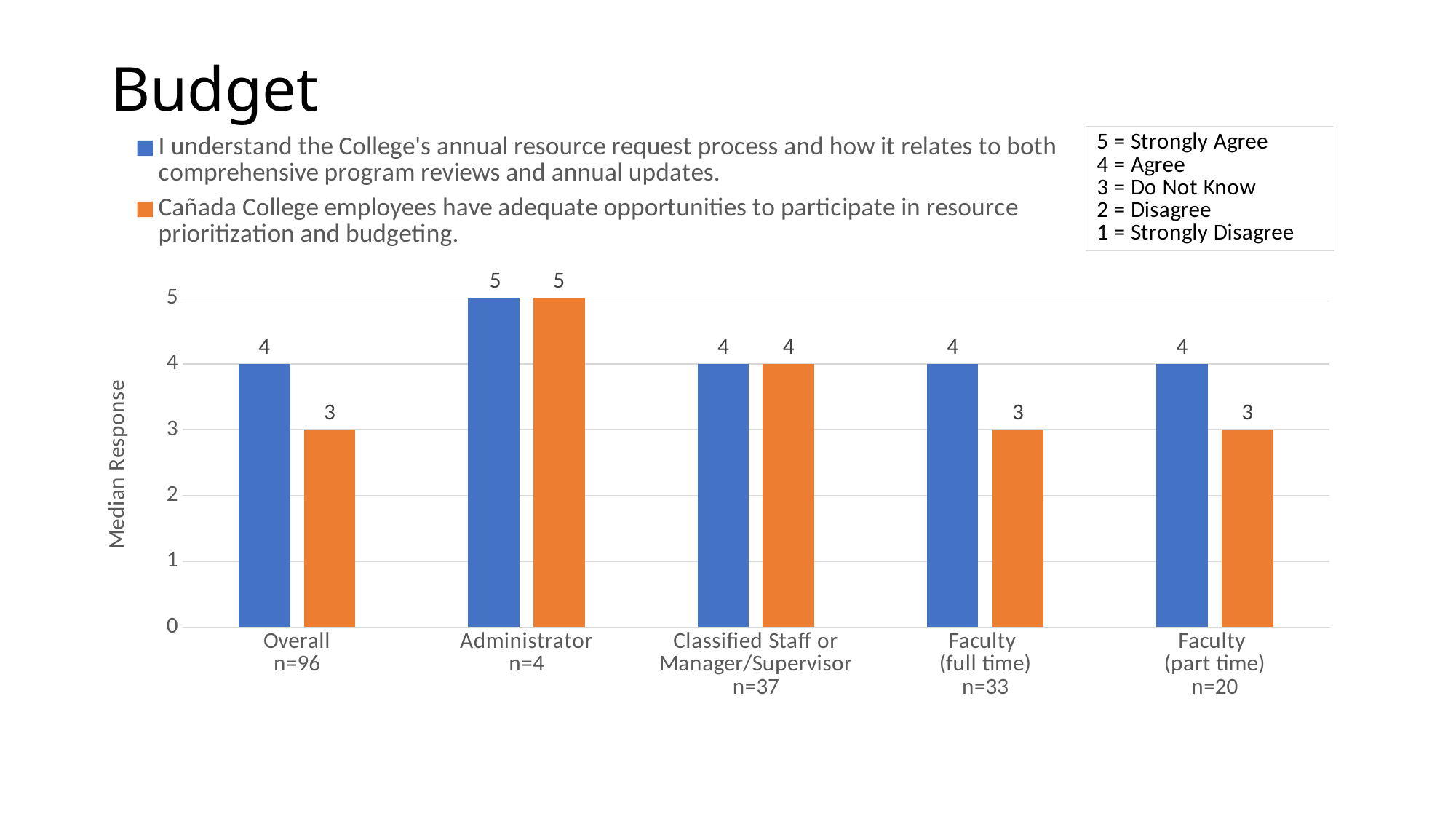
Which group has the highest median response for the statement 'I understand the College's annual resource request process...'? Administrator What is the difference between the two median responses for Faculty (full time)? 1 For Overall, which statement has the larger median response: the one about understanding the resource request process or the one about adequate opportunities to participate? I understand the College's annual resource request process What is the label of the vertical axis? Median Response What kind of chart is shown on the slide? Bar chart What is the median response for Overall on the statement 'I understand the College's annual resource request process and how it relates to both comprehensive program reviews and annual updates'? 4 What is the median response for Administrator on the statement about adequate opportunities to participate in resource prioritization and budgeting? 5 Is the median response for Faculty (full time) on the statement about adequate opportunities to participate greater or less than 4? less How many series does the legend list? 2 What is the median response for Faculty (part time) on the statement 'Cañada College employees have adequate opportunities to participate in resource prioritization and budgeting'? 3 How many groups are shown on the x axis of the chart? 5 What is the sample size (n) for Classified Staff or Manager/Supervisor? 37